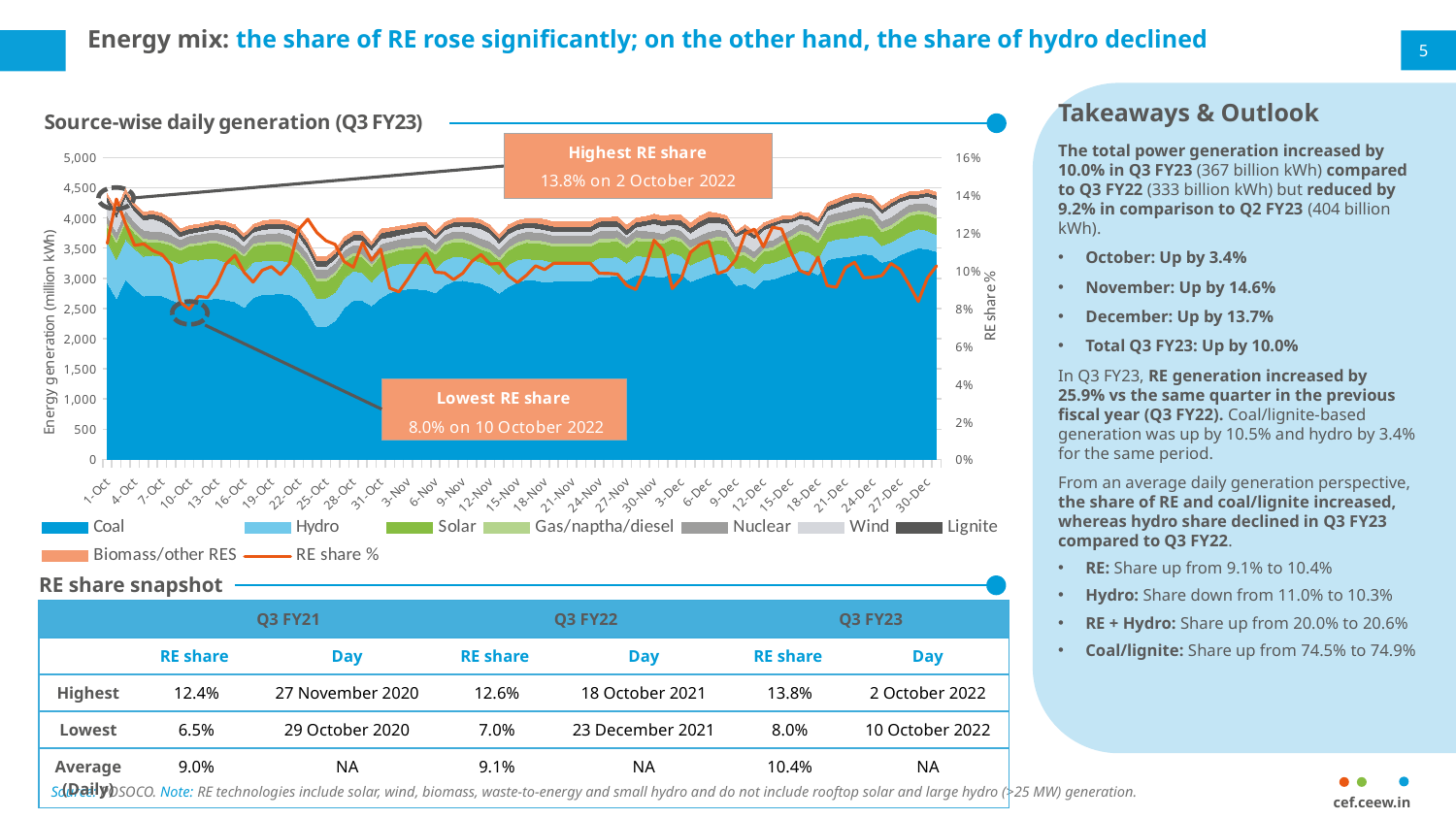
What is the lowest RE share shown in the Source-wise daily generation (Q3 FY23) chart? 8.0% What is the label of the left vertical axis in the Source-wise daily generation (Q3 FY23) chart? Energy generation (million kWh) What is the maximum value shown on the right-hand RE share % axis of the Source-wise daily generation (Q3 FY23) chart? 16% On which date did the lowest RE share occur in the Source-wise daily generation (Q3 FY23) chart? 10 October 2022 Is the RE share on 2 October 2022 in the Source-wise daily generation (Q3 FY23) chart greater or less than 12%? greater How many series does the legend of the Source-wise daily generation (Q3 FY23) chart list? 9 On which date did the highest RE share occur in the Source-wise daily generation (Q3 FY23) chart? 2 October 2022 What is the difference between the highest and lowest RE share in the Source-wise daily generation (Q3 FY23) chart? 5.8 percentage points Which date had the larger RE share in the Source-wise daily generation (Q3 FY23) chart: 2 October 2022 or 10 October 2022? 2 October 2022 What kind of chart is the Source-wise daily generation (Q3 FY23) chart? Stacked area chart with a line for RE share % What is the highest RE share shown in the Source-wise daily generation (Q3 FY23) chart? 13.8% Is the total energy generation on 1 October in the Source-wise daily generation (Q3 FY23) chart greater or less than 4,000 million kWh? greater